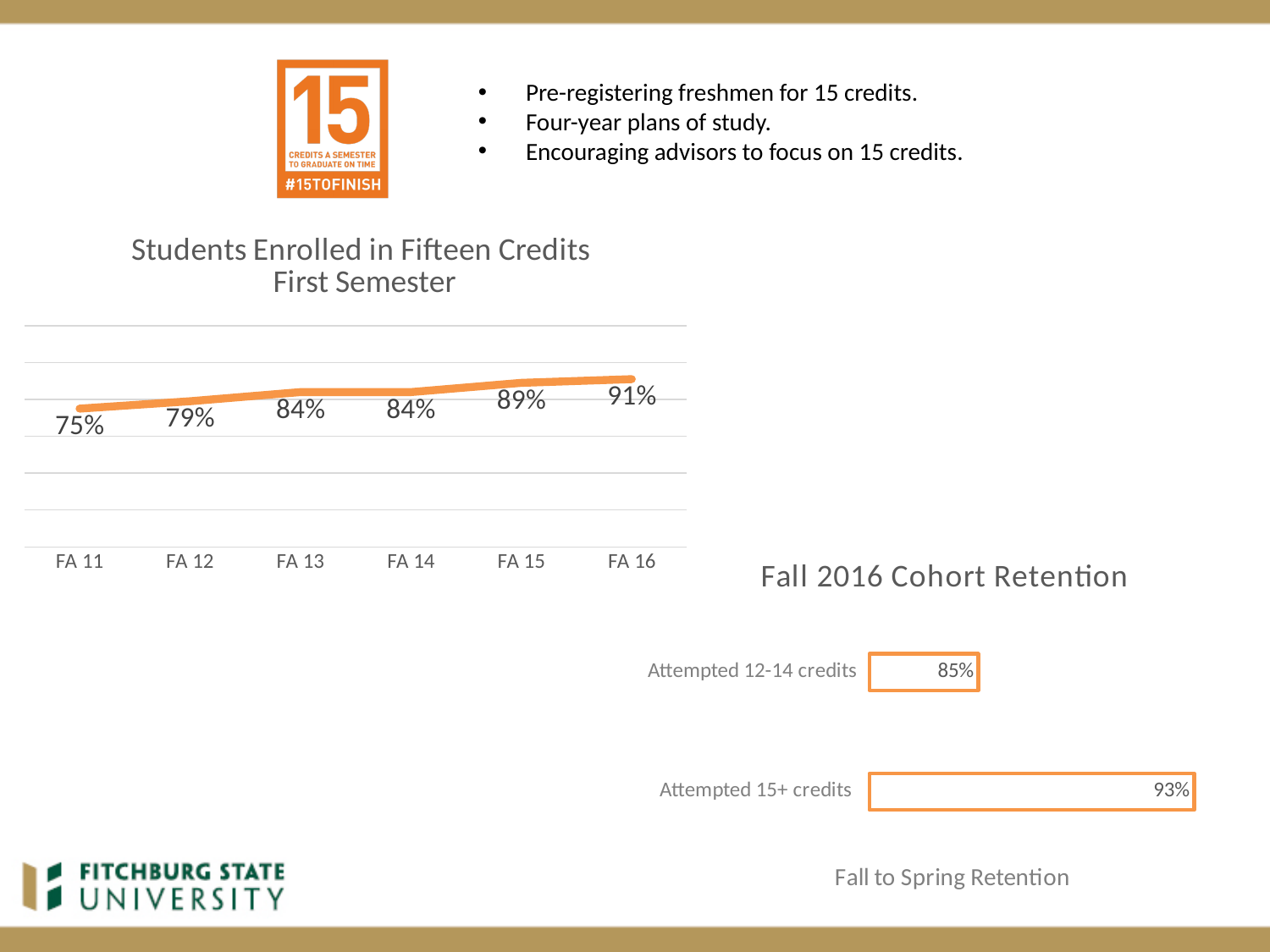
In the 'Fall 2016 Cohort Retention' chart, what is the difference between the 'Attempted 15+ credits' and 'Attempted 12-14 credits' values? 8% In the 'Fall 2016 Cohort Retention' chart, what is the value for 'Attempted 15+ credits'? 93% In the 'Students Enrolled in Fifteen Credits First Semester' chart, what is the value for FA 15? 89% In the 'Students Enrolled in Fifteen Credits First Semester' chart, how many semesters are plotted? 6 In the 'Students Enrolled in Fifteen Credits First Semester' chart, which semester has the lowest value? FA 11 In the 'Students Enrolled in Fifteen Credits First Semester' chart, what is the value for FA 11? 75% In the 'Students Enrolled in Fifteen Credits First Semester' chart, do the values generally rise or fall from FA 11 to FA 16? Rise In the 'Fall 2016 Cohort Retention' chart, what is the value for 'Attempted 12-14 credits'? 85% What kind of chart is 'Fall 2016 Cohort Retention'? Bar chart What kind of chart is 'Students Enrolled in Fifteen Credits First Semester'? Line chart In the 'Students Enrolled in Fifteen Credits First Semester' chart, what is the difference between the FA 16 and FA 11 values? 16% In the 'Students Enrolled in Fifteen Credits First Semester' chart, which semester has the highest value? FA 16